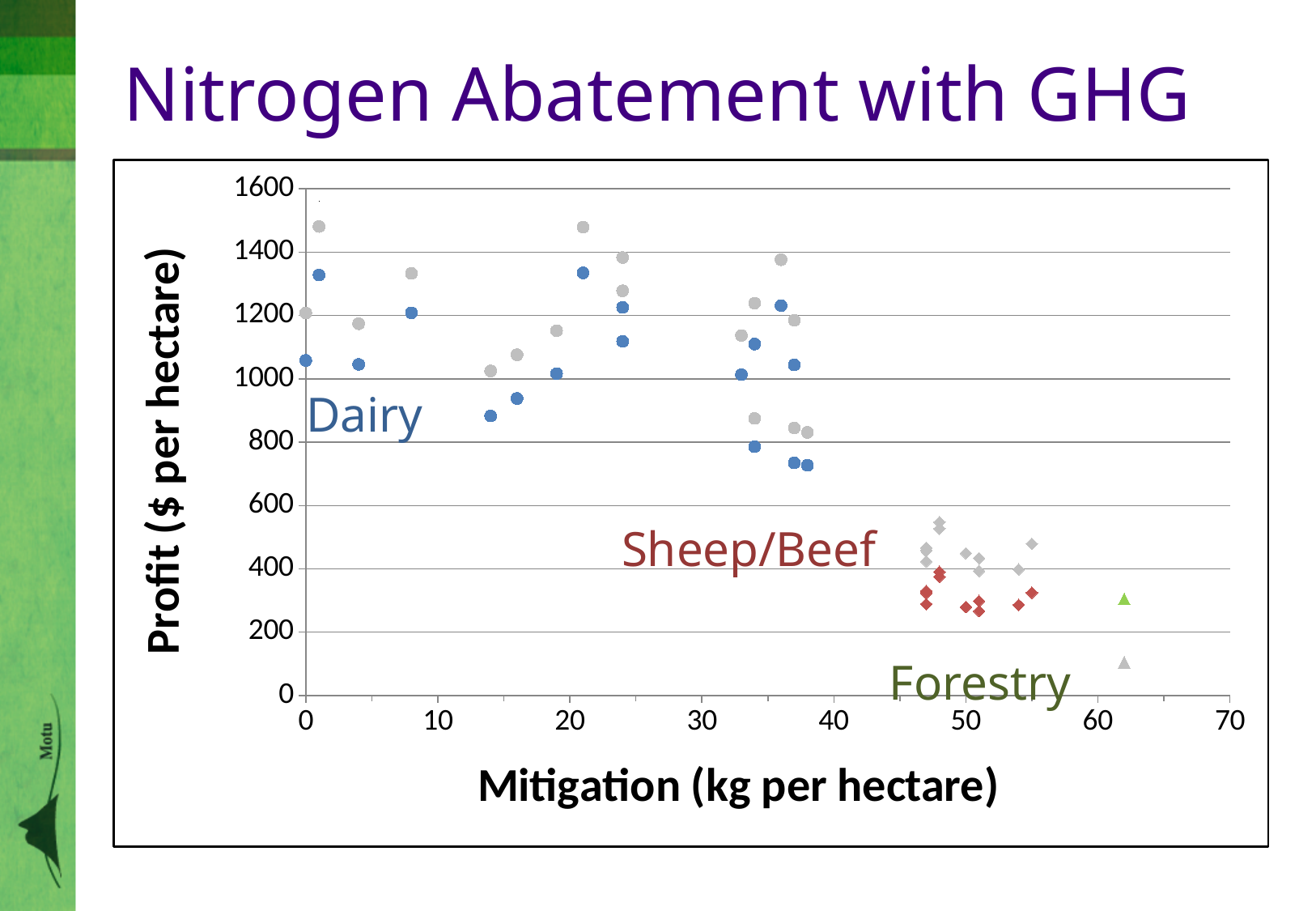
Which labelled group has the lowest profit per hectare? Forestry What is the label of the vertical axis? Profit ($ per hectare) Which labelled group has the highest profit per hectare? Dairy Which labelled group has the highest mitigation (kg per hectare)? Forestry Is the mitigation of the Forestry points greater or less than 50? greater Overall, does profit rise or fall as mitigation increases along the x axis? fall How many land-use groups are labelled on the chart? 3 What kind of chart is shown on the slide? scatter chart Are the Sheep/Beef red points above or below 600 on the profit axis? below Is the profit of the green Forestry point greater or less than 400? less Which group has higher profit per hectare, Dairy or Sheep/Beef? Dairy What is the title of the chart on the slide? Nitrogen Abatement with GHG